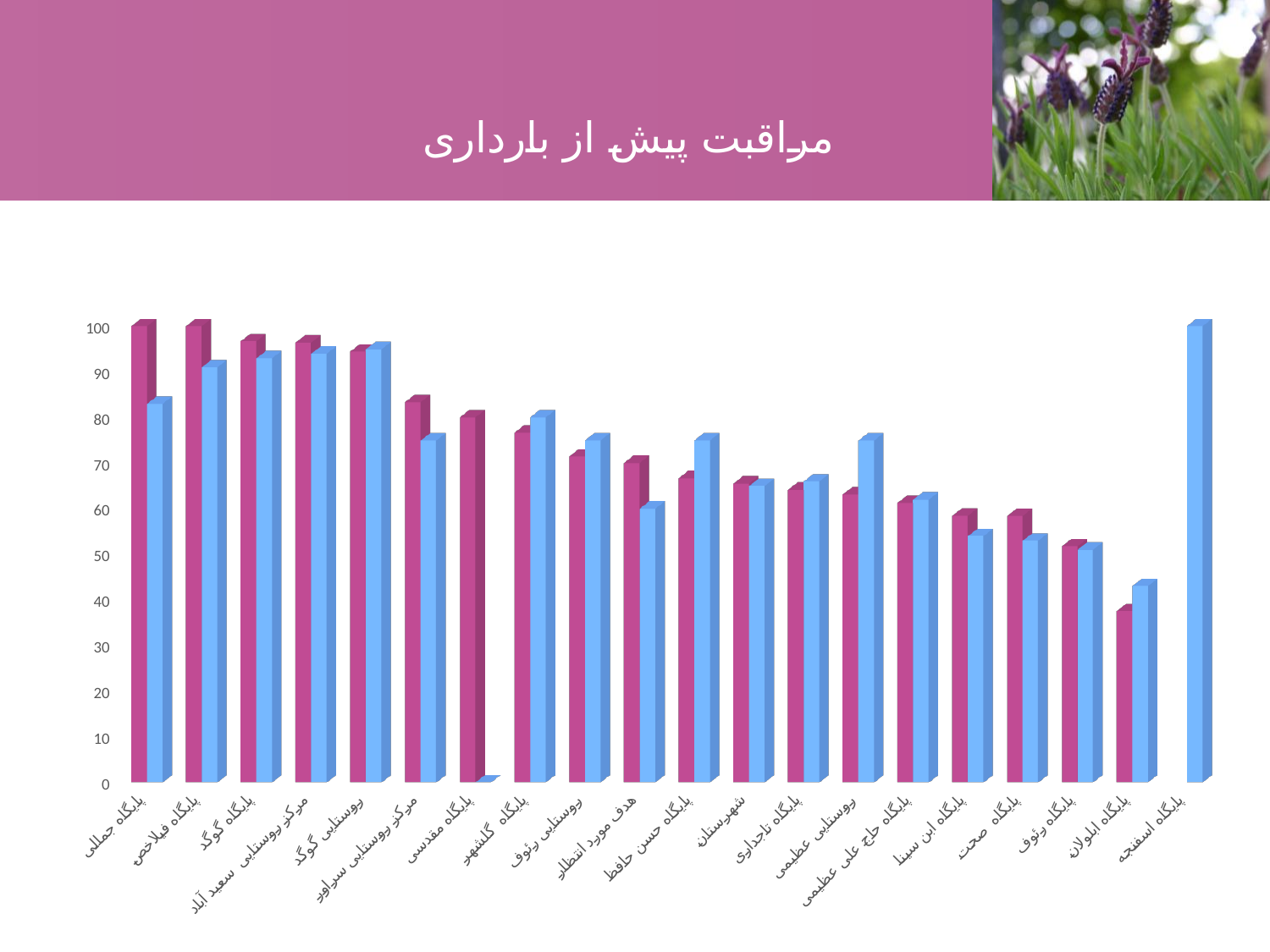
How many data series (bar colours) are plotted in the chart? 2 For پایگاه جمالی, which bar is taller, the magenta one or the blue one? magenta What kind of chart is shown on the slide? bar chart Is the blue bar for پایگاه گوگد greater or less than 80? greater What is the title of the slide containing the chart? مراقبت پیش از بارداری For روستایی عظیمی, which bar is taller, the magenta one or the blue one? blue Is the blue bar for پایگاه اسفنجه greater or less than 90? greater Do the magenta bars generally rise or fall from left to right along the x axis? fall Is the magenta bar for هدف مورد انتظار greater or less than 60? greater How many categories are shown along the x axis of the chart? 20